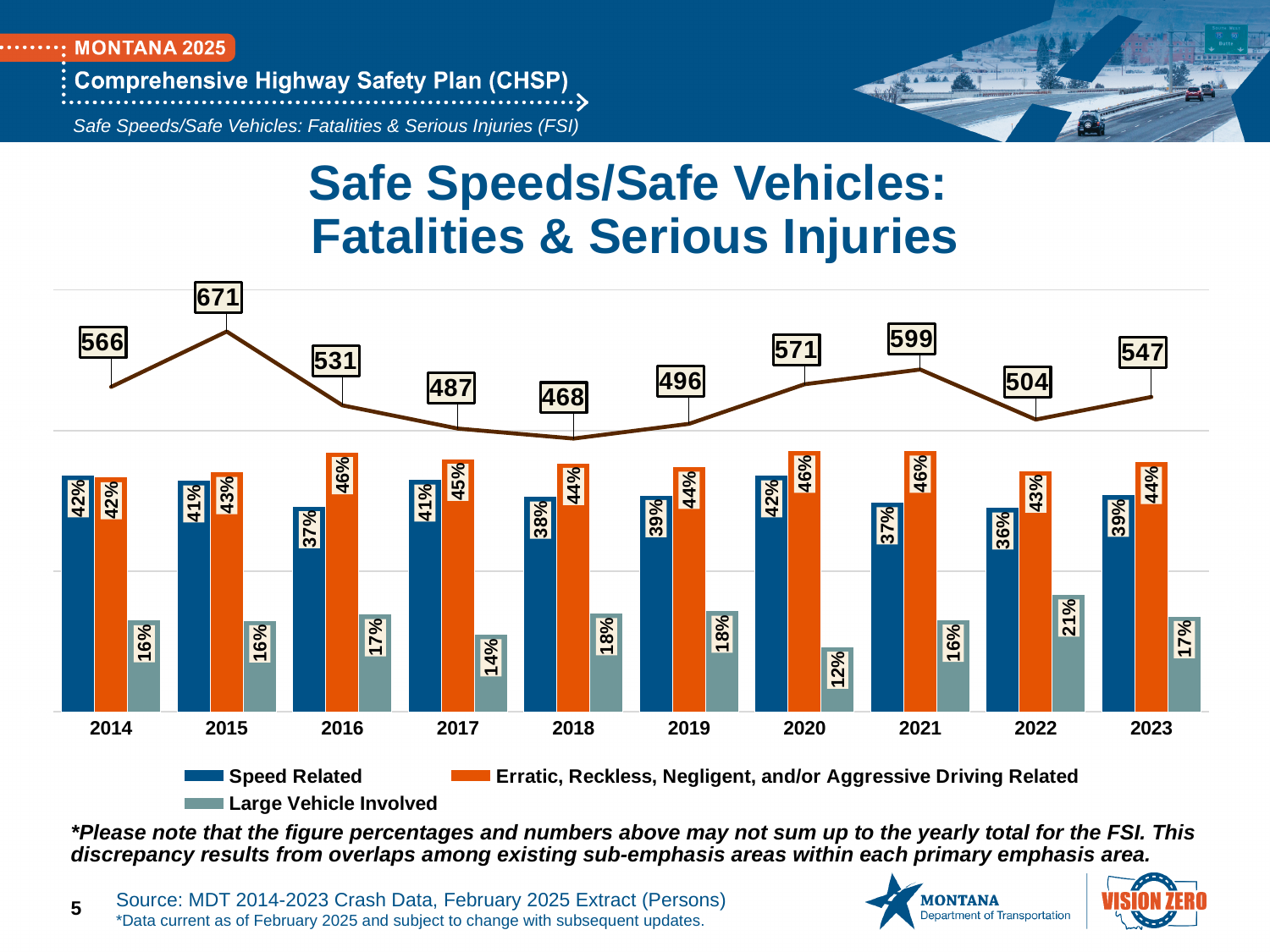
What percentage is shown for Large Vehicle Involved in 2022? 21% What kind of chart is shown on the slide? A bar chart combined with a line chart What is the Speed Related percentage for 2014? 42% How many series does the legend list? 3 In 2016, which is larger: the Speed Related percentage or the Erratic, Reckless, Negligent, and/or Aggressive Driving Related percentage? Erratic, Reckless, Negligent, and/or Aggressive Driving Related In which year is the Large Vehicle Involved percentage the lowest? 2020 By how much did the yearly total on the line fall from 2021 to 2022? 95 What is the total fatalities and serious injuries value shown on the line for 2015? 671 In which year is the Large Vehicle Involved percentage the highest? 2022 How many years are shown on the x axis of the chart? 10 Which year has the highest value on the line of yearly totals? 2015 Which year has the lowest value on the line of yearly totals? 2018